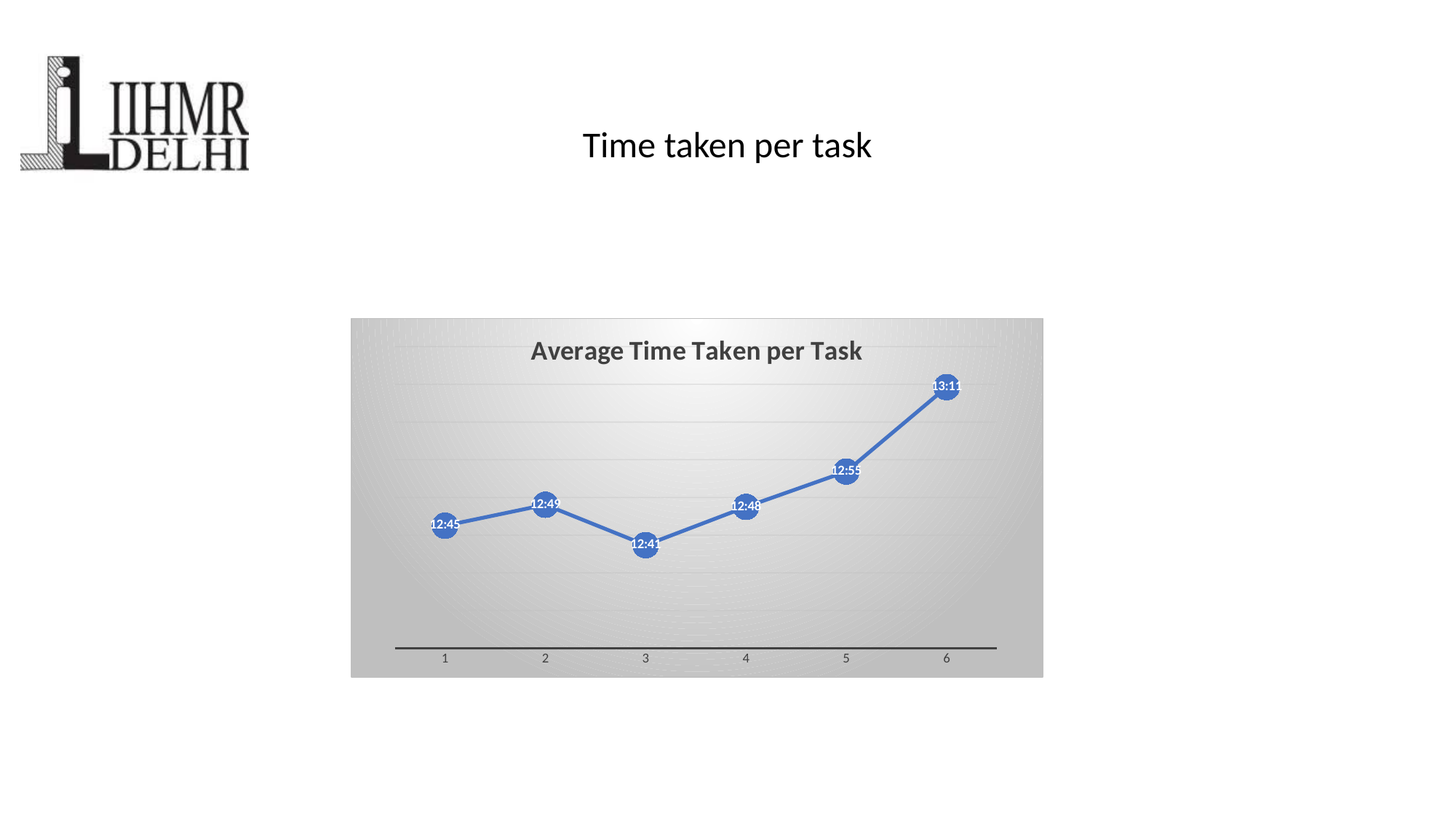
What is the value for task 1? 12:45 Which has a larger value, task 1 or task 5? Task 5 What is the value for task 6? 13:11 How many tasks are plotted on the chart? 6 Which has a larger value, task 2 or task 4? Task 2 What is the value for task 3? 12:41 What kind of chart is shown on the slide? Line chart Which task has the lowest average time taken? 3 What is the value for task 5? 12:55 What is the value for task 4? 12:48 What is the title of the chart? Average Time Taken per Task Which task has the highest average time taken? 6